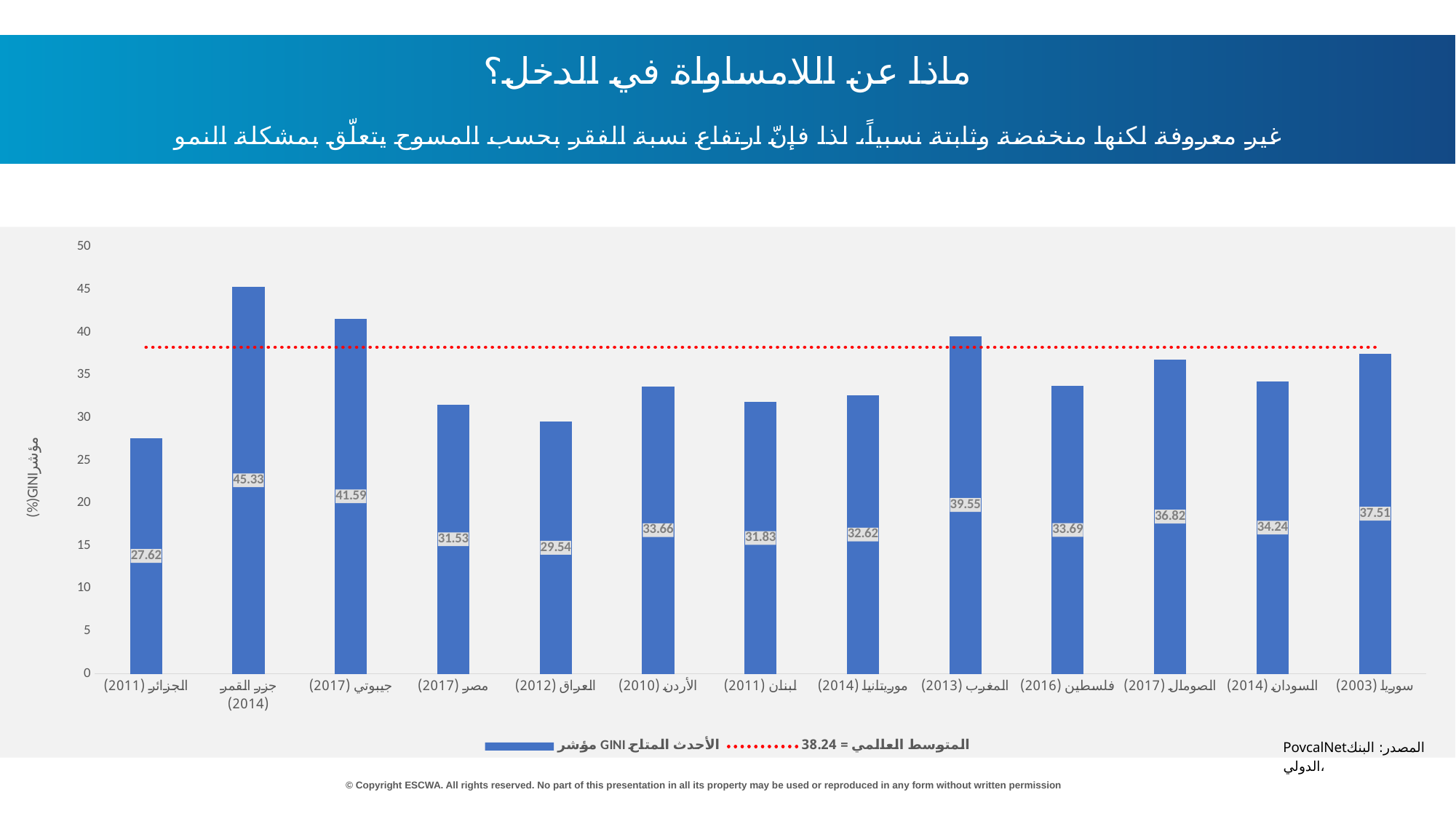
How many countries are shown in the bar chart? 13 What type of chart is shown on the slide? bar chart What is the GINI index value for المغرب (Morocco, 2013)? 39.55 How many entries does the legend list? 2 What is the GINI index value for سوريا (Syria, 2003)? 37.51 Is the GINI index value for العراق (2012) greater or less than 30? less Which has a higher GINI index value, الصومال (2017) or السودان (2014)? الصومال (2017) What value does the dotted red line representing the world average (المتوسط العالمي) mark? 38.24 Which country has the highest GINI index value in the chart? جزر القمر (2014) What is the GINI index value for الجزائر (Algeria, 2011)? 27.62 Which country has the lowest GINI index value in the chart? الجزائر (2011) What is the difference between the GINI index values of جزر القمر (2014) and جيبوتي (2017)? 3.74